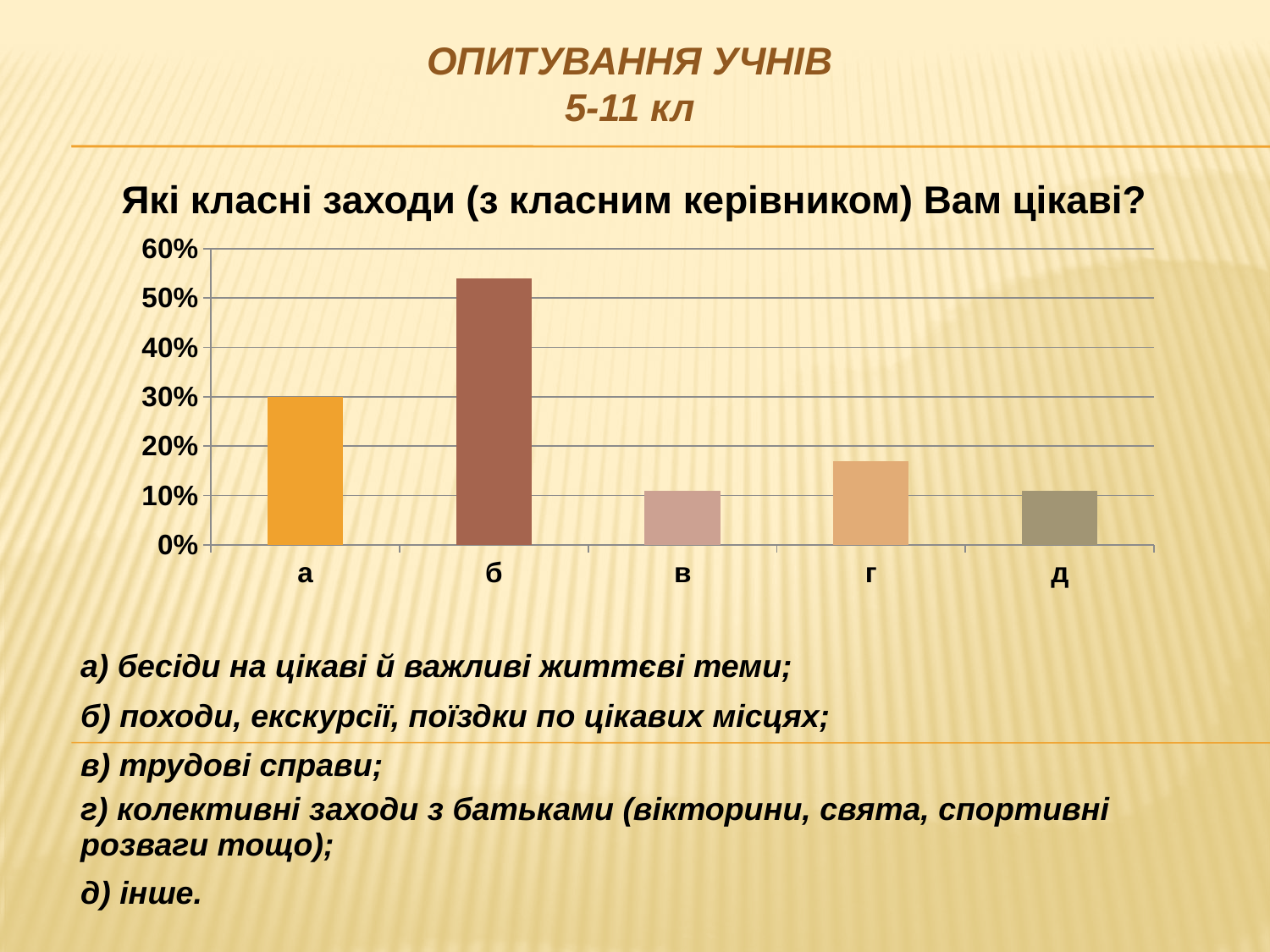
Is the value for а greater or less than 40%? less Is the value for г greater or less than 10%? greater Which is larger, the value for г or the value for в? г Is the value for г greater or less than 20%? less Which category has the highest value in the chart? б Which is larger, the value for а or the value for г? а How many categories are shown on the x axis of the chart? 5 What kind of chart is shown on the slide? bar chart Which is larger, the value for б or the value for а? б What is the title of the chart? Які класні заходи (з класним керівником) Вам цікаві?